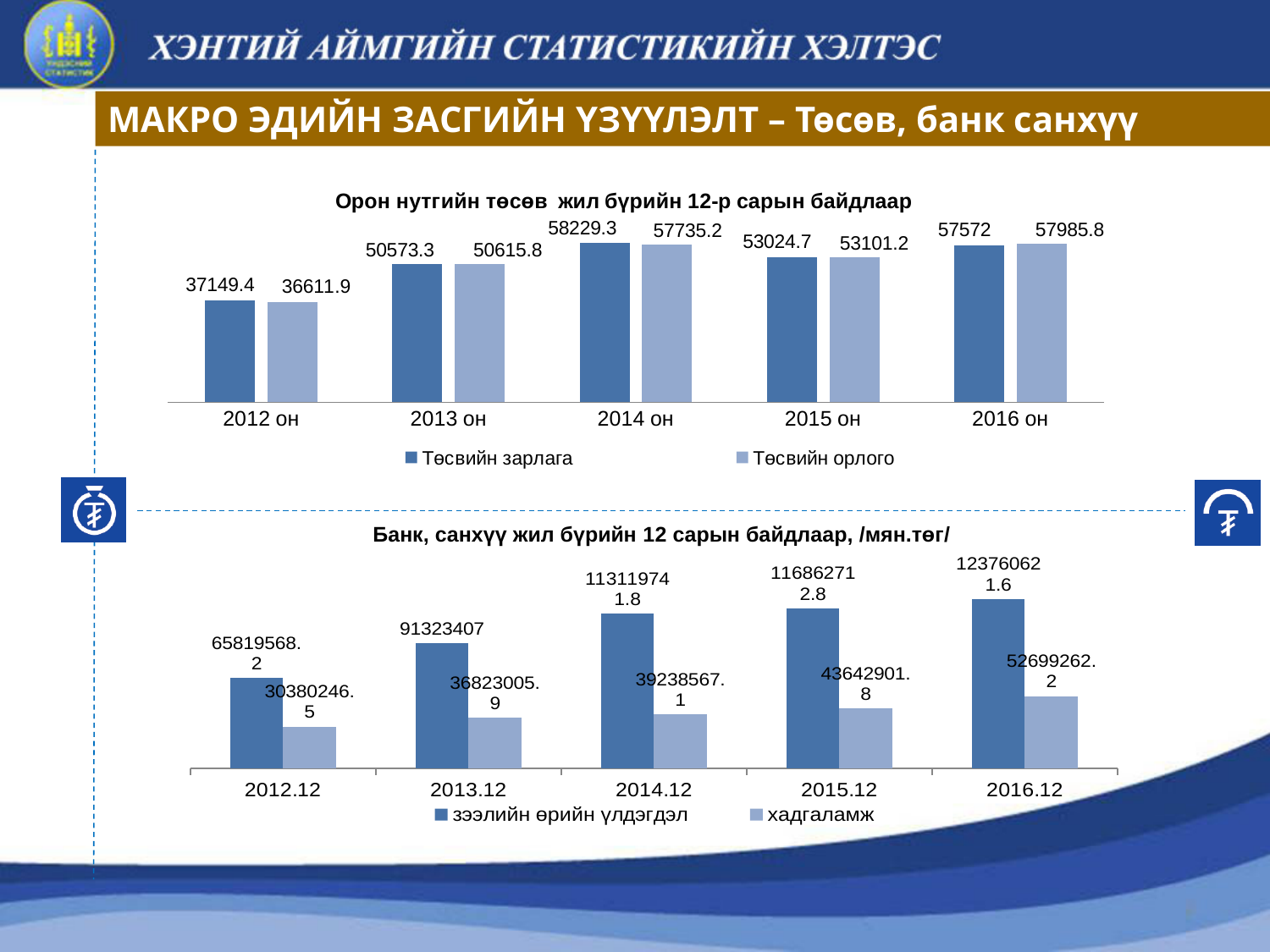
What type of chart is the bottom chart (Банк, санхүү)? bar chart In the top chart (Орон нутгийн төсөв), what is the value of Төсвийн орлого for 2016 он? 57985.8 In the top chart (Орон нутгийн төсөв), what is the value of Төсвийн зарлага for 2012 он? 37149.4 In the top chart (Орон нутгийн төсөв), how many series does the legend list? 2 In the bottom chart (Банк, санхүү), which is larger in 2012.12: зээлийн өрийн үлдэгдэл or хадгаламж? зээлийн өрийн үлдэгдэл In the bottom chart (Банк, санхүү), does хадгаламж rise or fall from 2012.12 to 2016.12? rise In the bottom chart (Банк, санхүү), what is the value of хадгаламж for 2016.12? 52699262.2 In the bottom chart (Банк, санхүү), what is the value of зээлийн өрийн үлдэгдэл for 2013.12? 91323407 In the top chart (Орон нутгийн төсөв), how many years are shown on the x axis? 5 In the top chart (Орон нутгийн төсөв), what is the difference between Төсвийн зарлага and Төсвийн орлого in 2014 он? 494.1 In the top chart (Орон нутгийн төсөв), which year has the highest Төсвийн зарлага? 2014 он In the top chart (Орон нутгийн төсөв), which year has the lowest Төсвийн орлого? 2012 он